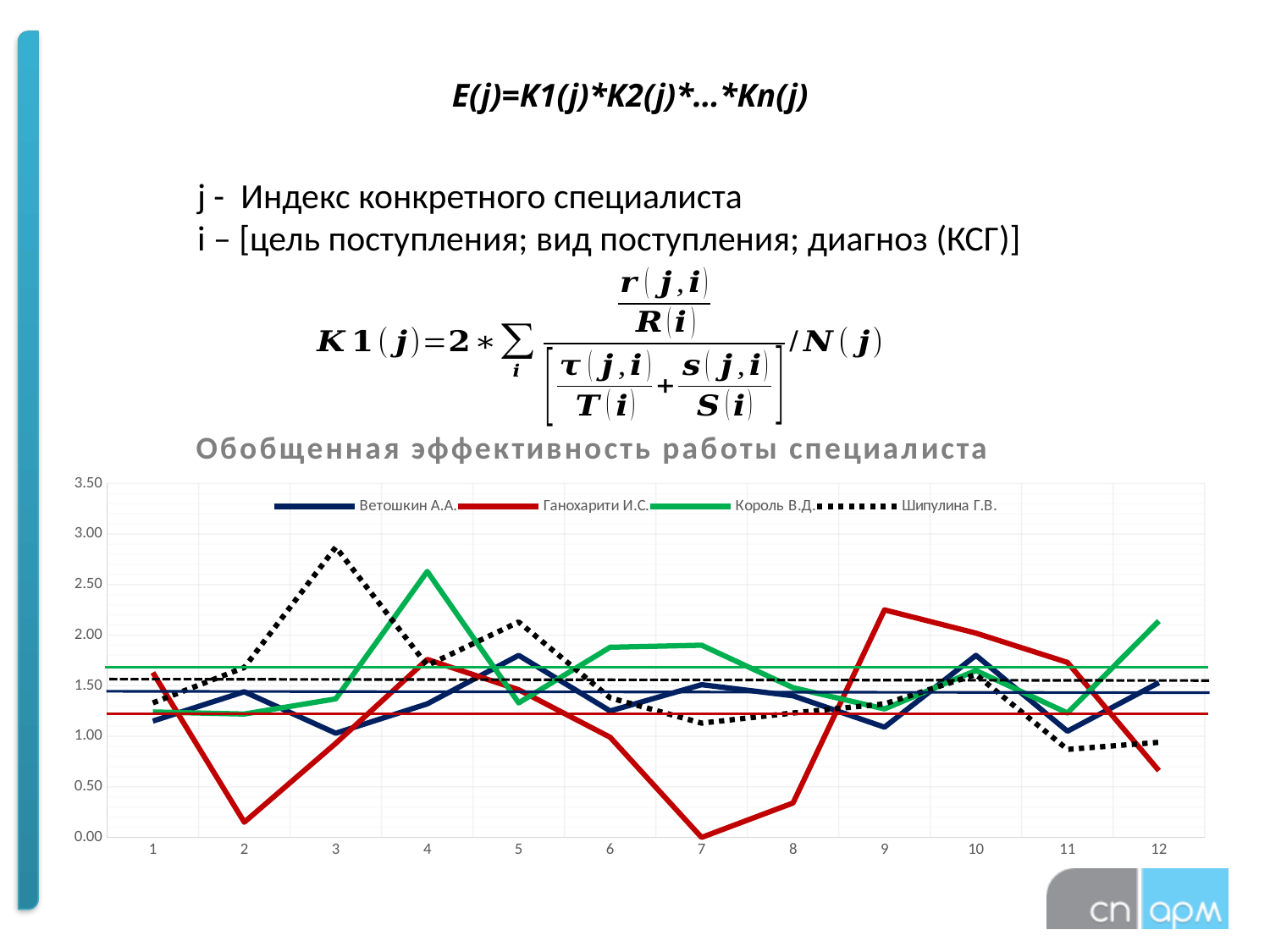
At point 4, which series has the larger value: Король В.Д. or Ветошкин А.А.? Король В.Д. Is the value for Шипулина Г.В. at point 3 greater or less than 2.50? greater Which series has the highest value at point 3? Шипулина Г.В. Is the value for Ганохарити И.С. at point 7 greater or less than 0.50? less Is the value for Ганохарити И.С. at point 9 greater or less than 2.00? greater How many points are there along the x axis of the chart? 12 What is the title of the chart? Обобщенная эффективность работы специалиста What kind of chart is shown on the slide? line chart Does the line for Ганохарити И.С. rise or fall from point 9 to point 12? fall Which series has the lowest value at point 7? Ганохарити И.С. How many series does the chart legend list? 4